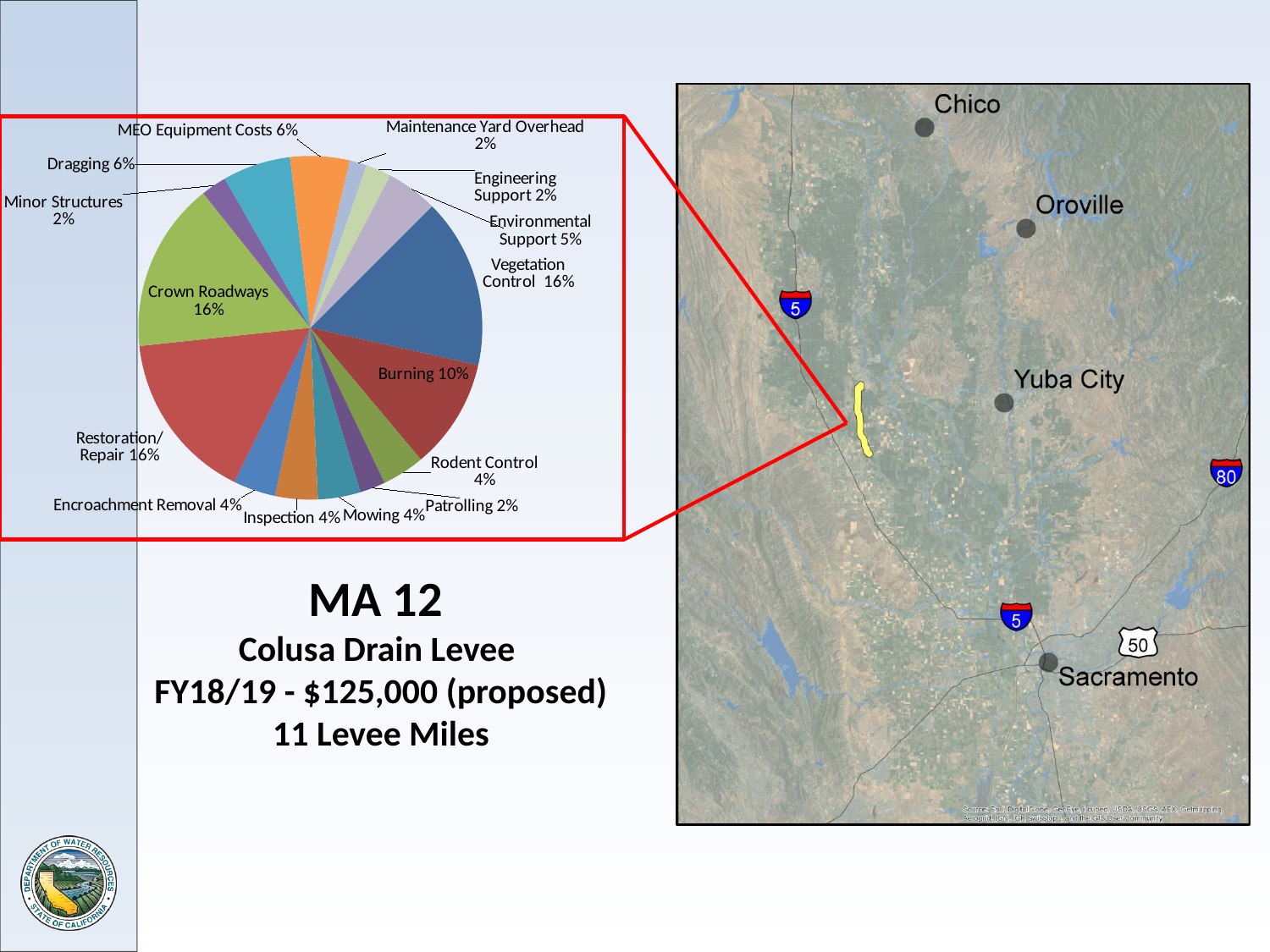
What percentage is shown for Dragging? 6% What percentage is shown for Rodent Control? 4% What is the difference between the Restoration/Repair share and the Encroachment Removal share? 12% How many categories are shown in the pie chart? 15 What percentage is shown for Maintenance Yard Overhead? 2% What share of the pie does Crown Roadways account for? 16% What percentage is shown for Environmental Support? 5% What kind of chart is shown on the slide? pie chart What is the difference between the Vegetation Control share and the Burning share? 6% What percentage is shown for Vegetation Control? 16% What share of the pie does Burning account for? 10% Which is larger, the share for Burning or the share for Dragging? Burning